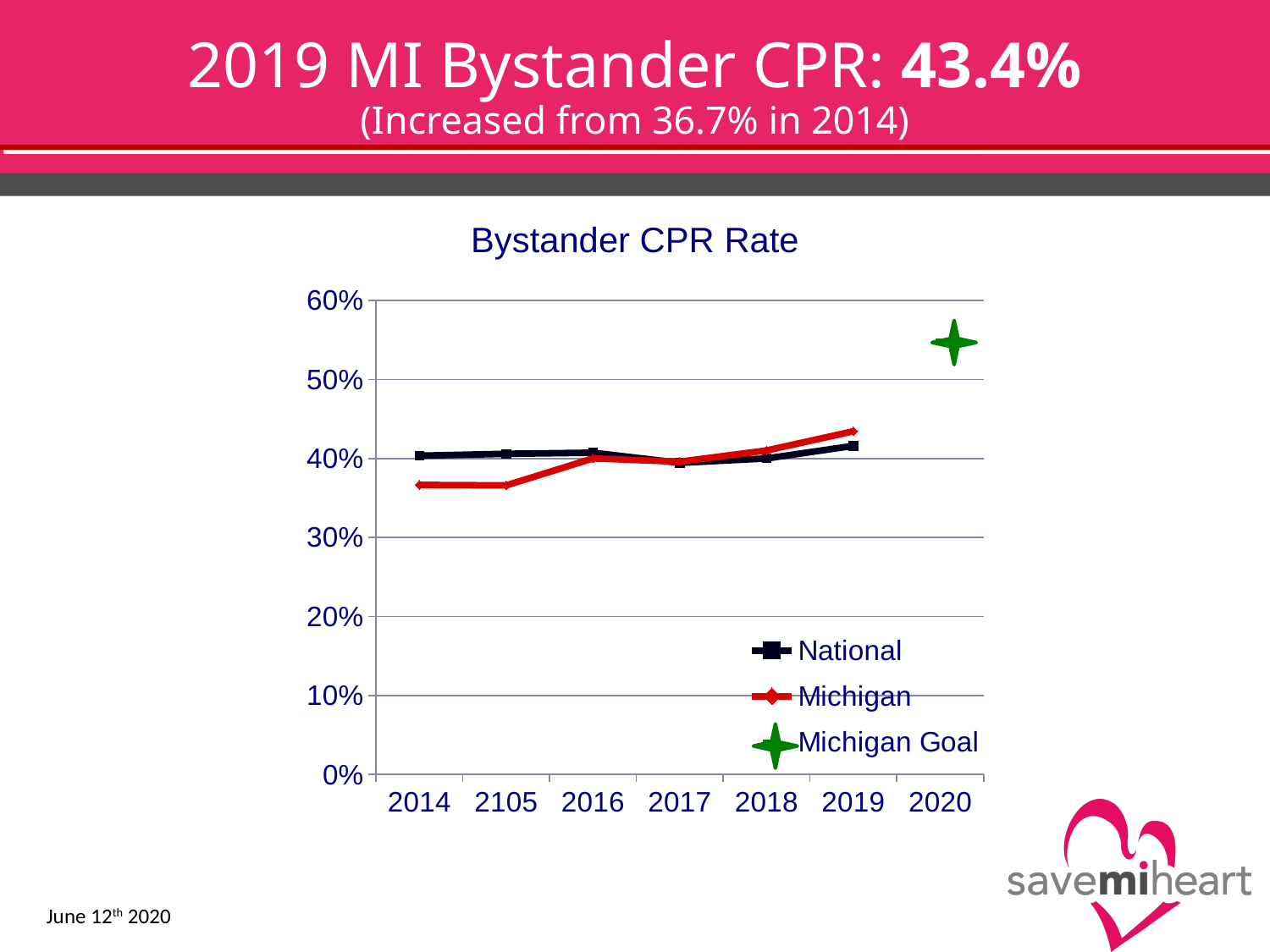
What is the title of the chart? Bystander CPR Rate In 2014, which series has the higher value, National or Michigan? National In 2019, which series has the higher value, National or Michigan? Michigan How many series does the chart legend list? 3 What type of chart is shown on the slide? line chart Does the Michigan series rise or fall from 2014 to 2019? rise By how many percentage points did the Michigan bystander CPR rate increase from 2014 to 2019? 6.7 How many year labels are shown on the x axis of the chart? 7 What was the Michigan bystander CPR rate in 2019? 43.4% Is the Michigan value for 2014 greater or less than 40%? less What was the Michigan bystander CPR rate in 2014? 36.7% Is the Michigan Goal value for 2020 greater or less than 50%? greater